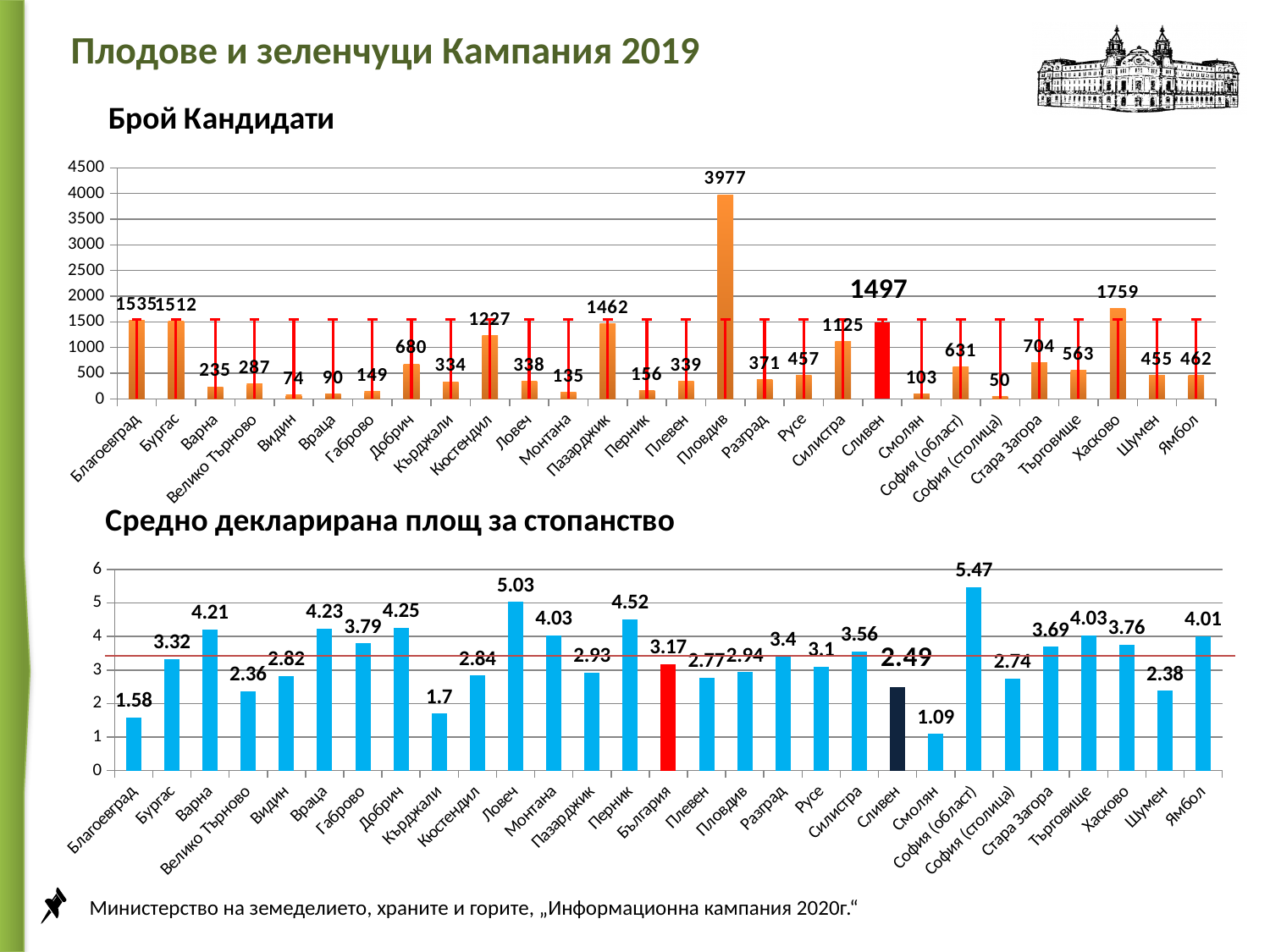
In the 'Средно декларирана площ за стопанство' chart, what is the difference between the values for Ловеч and Благоевград? 3.45 In the 'Брой Кандидати' chart, what is the value for Пловдив? 3977 In the 'Брой Кандидати' chart, which category has the highest value? Пловдив What kind of chart is the 'Брой Кандидати' chart? Bar chart In the 'Средно декларирана площ за стопанство' chart, what is the value for София (област)? 5.47 In the 'Брой Кандидати' chart, what is the value for Сливен? 1497 In the 'Брой Кандидати' chart, what is the difference between the values for Хасково and Силистра? 634 In the 'Средно декларирана площ за стопанство' chart, which category has the lowest value? Смолян In the 'Брой Кандидати' chart, which category has the lowest value? София (столица) How many categories are shown in the 'Средно декларирана площ за стопанство' chart? 29 In the 'Брой Кандидати' chart, which is larger, the value for Кюстендил or the value for Пазарджик? Пазарджик In the 'Средно декларирана площ за стопанство' chart, which is larger, the value for Варна or the value for Бургас? Варна